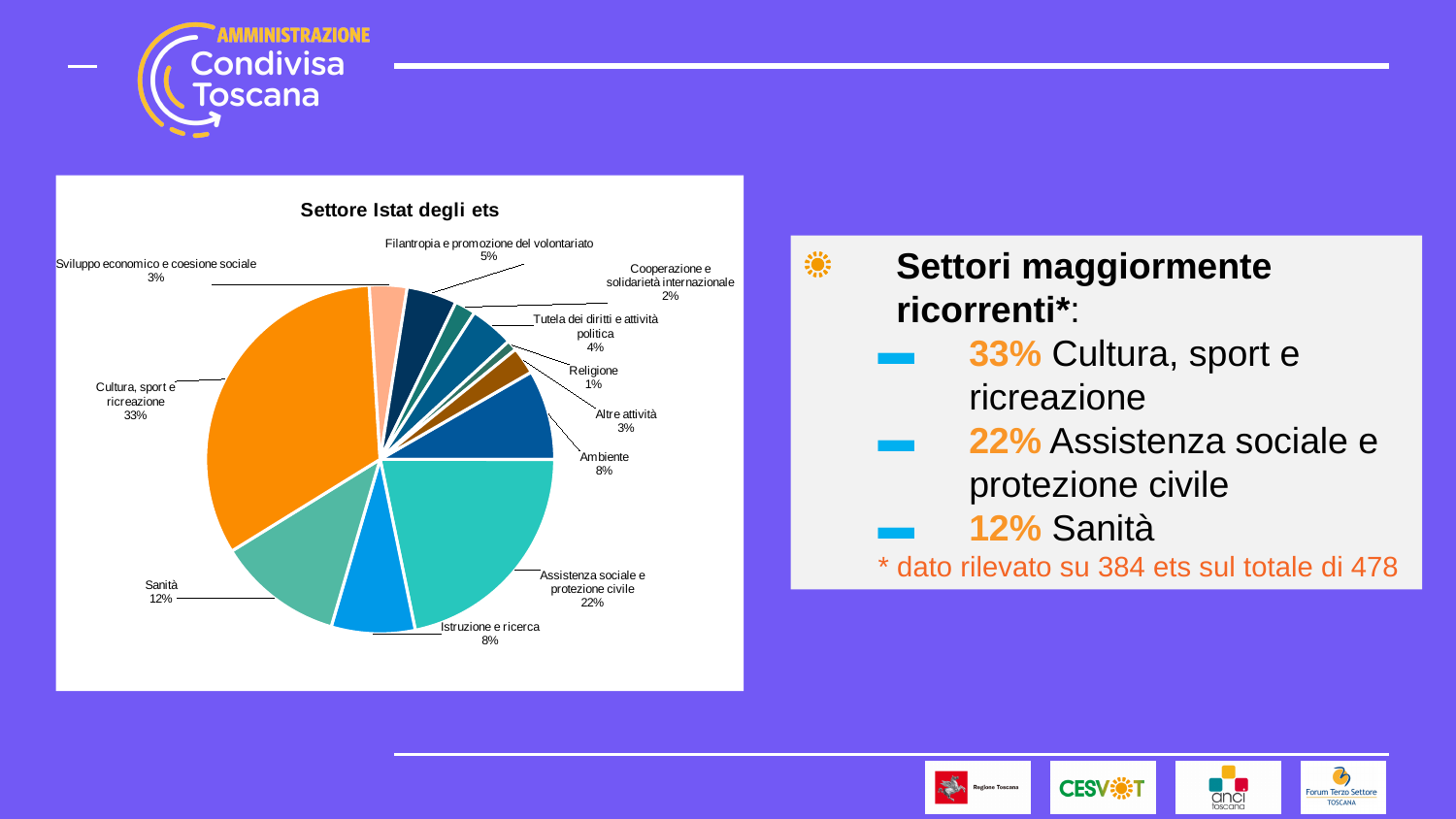
How many slices does the pie chart have? 11 Which is larger, Ambiente or Filantropia e promozione del volontariato? Ambiente What is the difference in percentage points between Cultura, sport e ricreazione and Assistenza sociale e protezione civile? 11 What is the value shown for Tutela dei diritti e attività politica? 4% What is the title of the chart? Settore Istat degli ets What is the value shown for Sanità? 12% What kind of chart is shown on the slide? pie chart What share of the pie does Cultura, sport e ricreazione represent? 33% What is the value shown for Religione? 1% What is the value shown for Assistenza sociale e protezione civile? 22% Which sector has the largest slice of the pie? Cultura, sport e ricreazione Which sector has the smallest slice of the pie? Religione